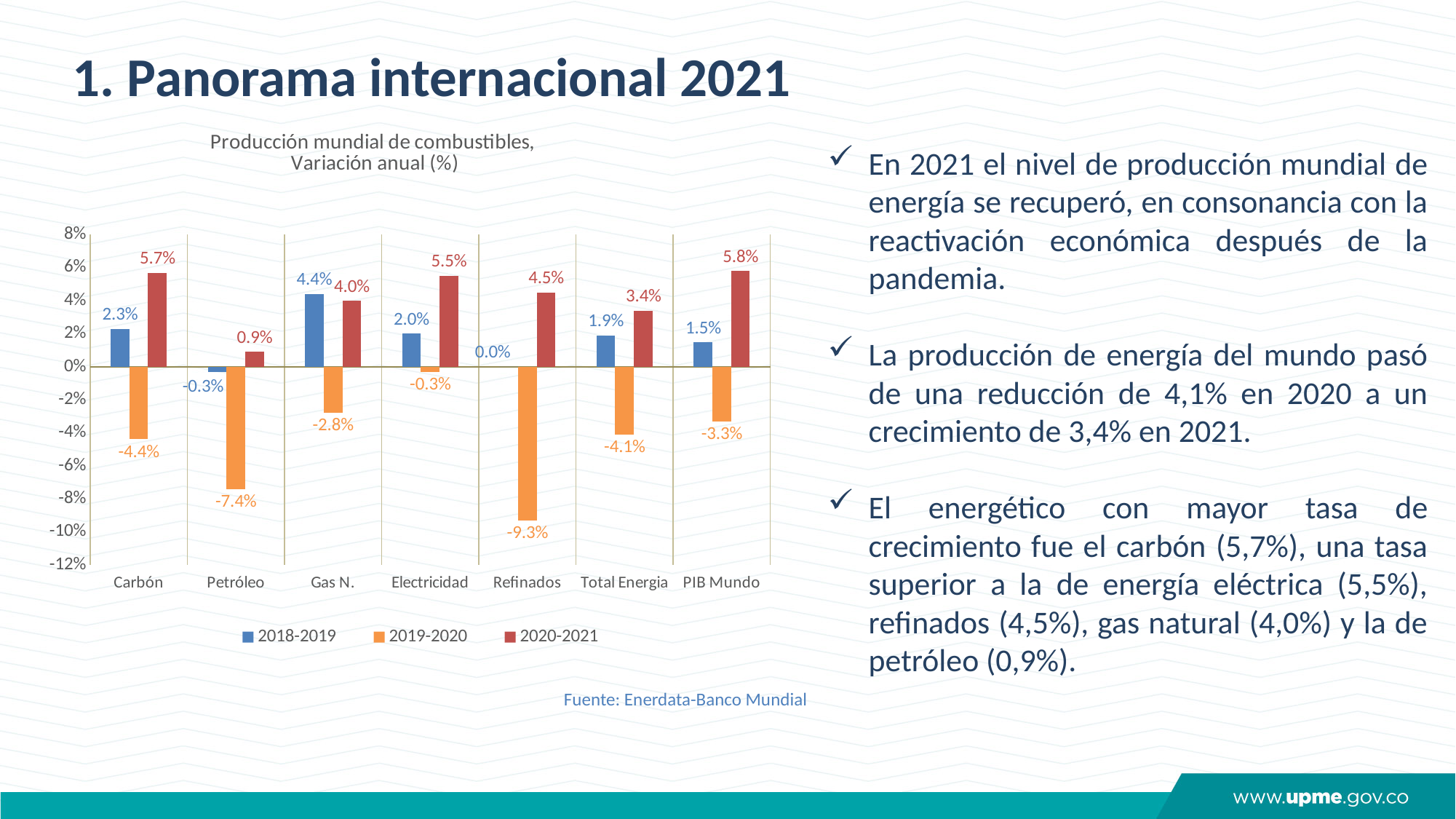
What is the 2020-2021 value for Total Energia? 3.4% Which category has the highest 2020-2021 value? PIB Mundo What kind of chart is shown on the slide? Bar chart Which category has the lowest 2019-2020 value? Refinados What is the 2019-2020 value for Refinados? -9.3% How many series does the legend list? 3 How many categories are shown on the x axis? 7 What is the 2018-2019 value for Gas N.? 4.4% What is the source cited below the chart? Enerdata-Banco Mundial What is the 2020-2021 value for Carbón? 5.7% Which is larger: the 2018-2019 value for Gas N. or the 2018-2019 value for Carbón? Gas N. What is the difference between the 2020-2021 value for Carbón and the 2020-2021 value for Petróleo? 4.8%